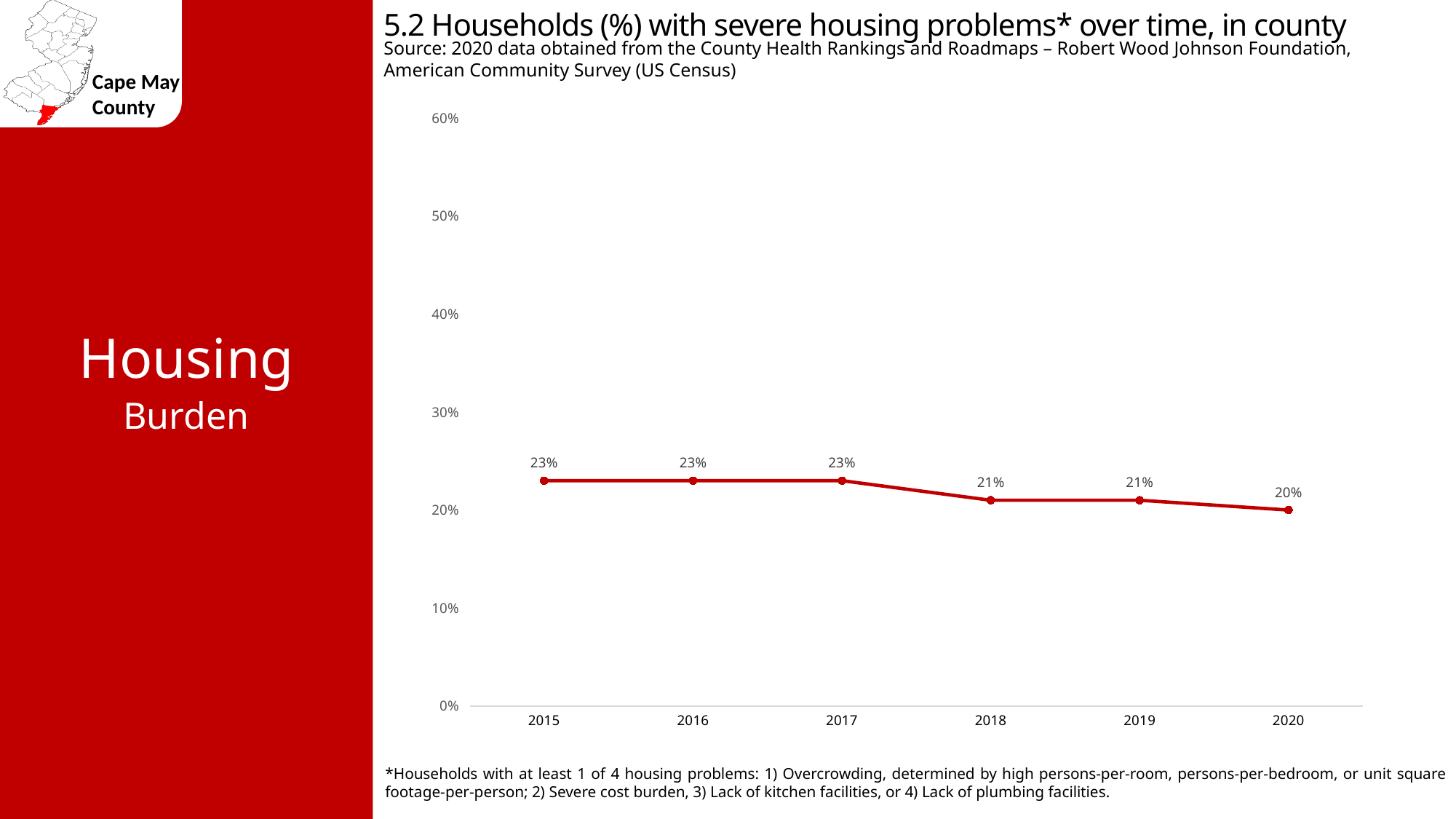
What kind of chart is shown on the slide? line chart What is the title of the chart? 5.2 Households (%) with severe housing problems* over time, in county Is the value for 2019 greater or less than 30%? less How many years are plotted on the chart? 6 What is the highest value shown on the y axis? 60% Which year shows the lowest percentage of households with severe housing problems? 2020 What percentage of households had severe housing problems in 2015? 23% What percentage of households had severe housing problems in 2020? 20% Which is larger, the value for 2016 or the value for 2019? 2016 What percentage of households had severe housing problems in 2018? 21% Do the values rise or fall from 2015 to 2020? fall What is the difference in percentage points between the 2017 value and the 2020 value? 3